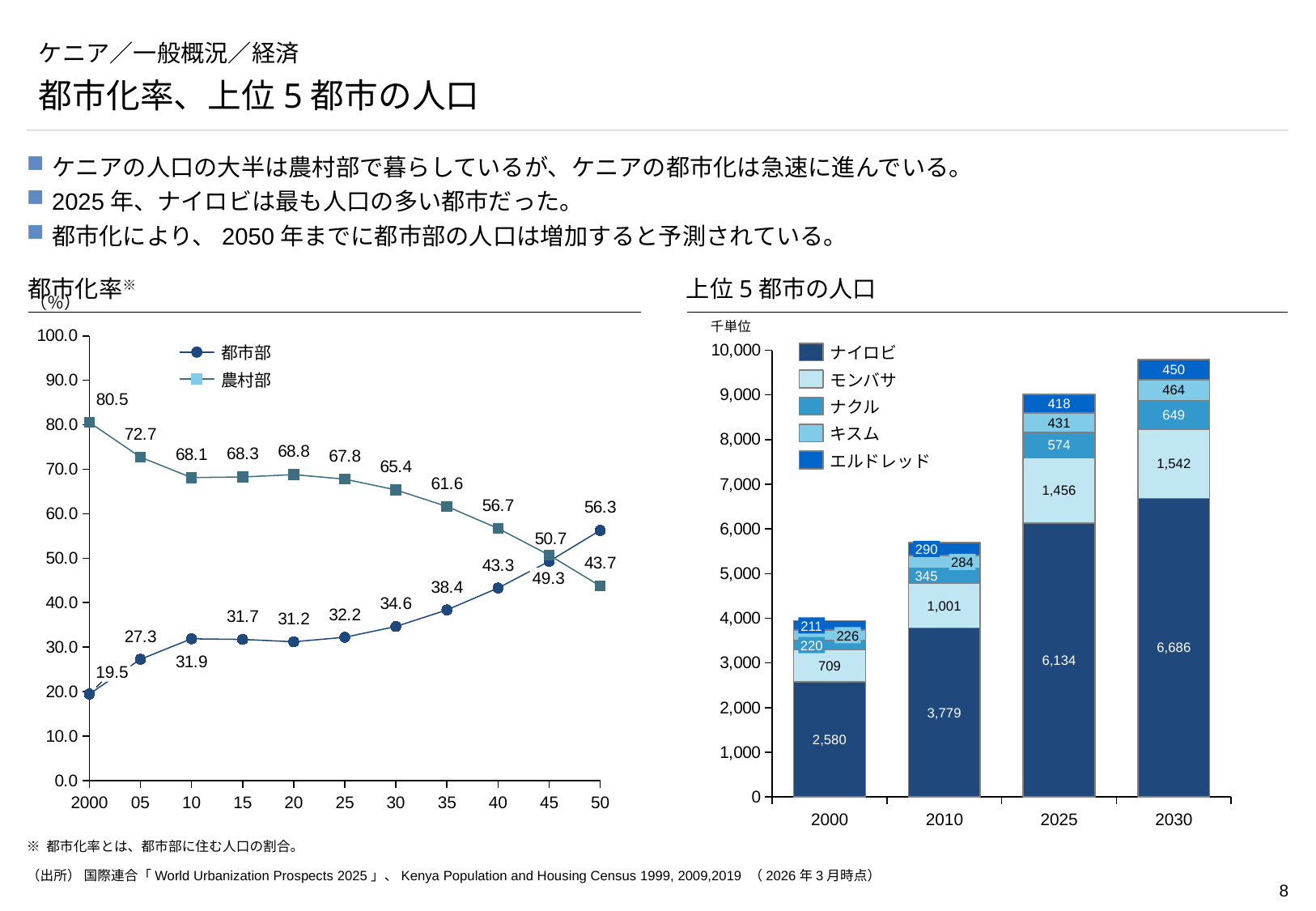
In the 都市化率 chart, in which year does 都市部 reach its highest value? 2050 In the 上位5都市の人口 chart, how many series does the legend list? 5 In the 都市化率 chart, what is the difference between 農村部 and 都市部 in 2000? 61.0 In the 都市化率 chart, what is the value for 都市部 in 2000? 19.5 In the 上位5都市の人口 chart, what is the difference between モンバサ in 2030 and モンバサ in 2010? 541 What kind of chart is the 都市化率 chart? line chart In the 都市化率 chart, how many series does the legend list? 2 In the 都市化率 chart, does the 農村部 series rise or fall from 2000 to 2050? fall In the 上位5都市の人口 chart, what is the value for ナイロビ in 2025? 6,134 In the 上位5都市の人口 chart, what is the total of the stacked bar for 2000? 3,946 In the 都市化率 chart, which is larger in 2045: 都市部 or 農村部? 農村部 In the 都市化率 chart, what is the value for 農村部 in 2050? 43.7